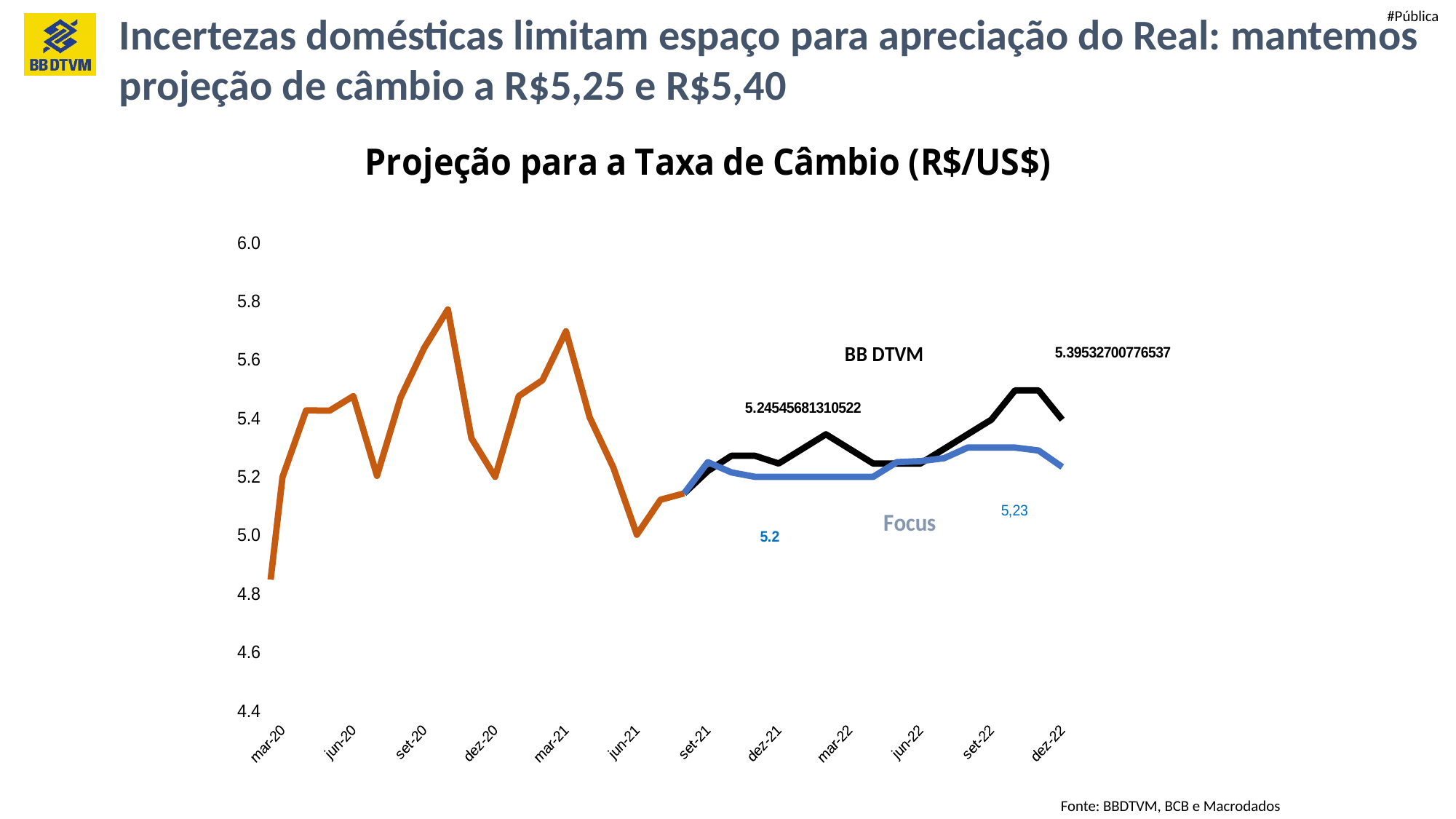
What is the difference between the BB DTVM and Focus labelled values at dez-22? 0.16532700776537 What value is labelled for the BB DTVM projection at dez-21? 5.24545681310522 What value is labelled for the Focus projection at dez-21? 5.2 Is the value of the orange line at mar-21 greater or less than 5.6? greater At dez-22, which projection is higher, BB DTVM or Focus? BB DTVM What is the title of the chart? Projeção para a Taxa de Câmbio (R$/US$) How many date labels are shown on the x axis? 12 What value is labelled for the Focus projection at dez-22? 5,23 What kind of chart is shown on the slide? line chart Does the BB DTVM line rise or fall between jun-22 and set-22? rise What value is labelled for the BB DTVM projection at dez-22? 5.39532700776537